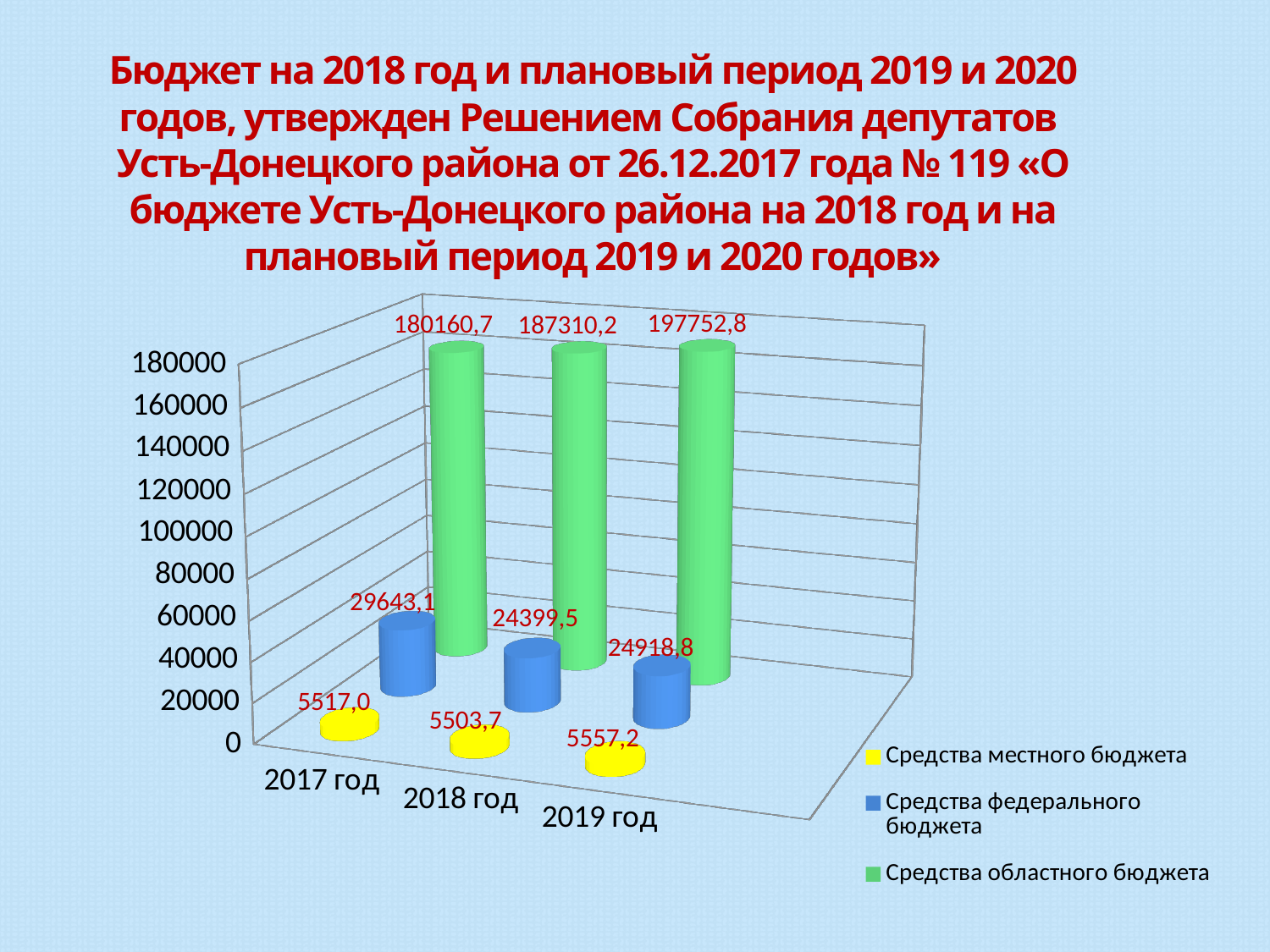
In which year is Средства федерального бюджета lowest? 2018 год What is the difference between Средства федерального бюджета in 2017 год and in 2018 год? 5243,6 Which is larger: Средства федерального бюджета in 2019 год or in 2018 год? 2019 год What is the value for Средства областного бюджета in 2017 год? 180160,7 How many years are shown on the x axis? 3 What is the difference between Средства областного бюджета in 2019 год and in 2017 год? 17592,1 Is the value for Средства областного бюджета in 2018 год greater or less than 180000? greater How many series does the legend list? 3 In which year is Средства областного бюджета highest? 2019 год What is the value for Средства местного бюджета in 2019 год? 5557,2 What is the value for Средства федерального бюджета in 2018 год? 24399,5 What kind of chart is shown on the slide? bar chart